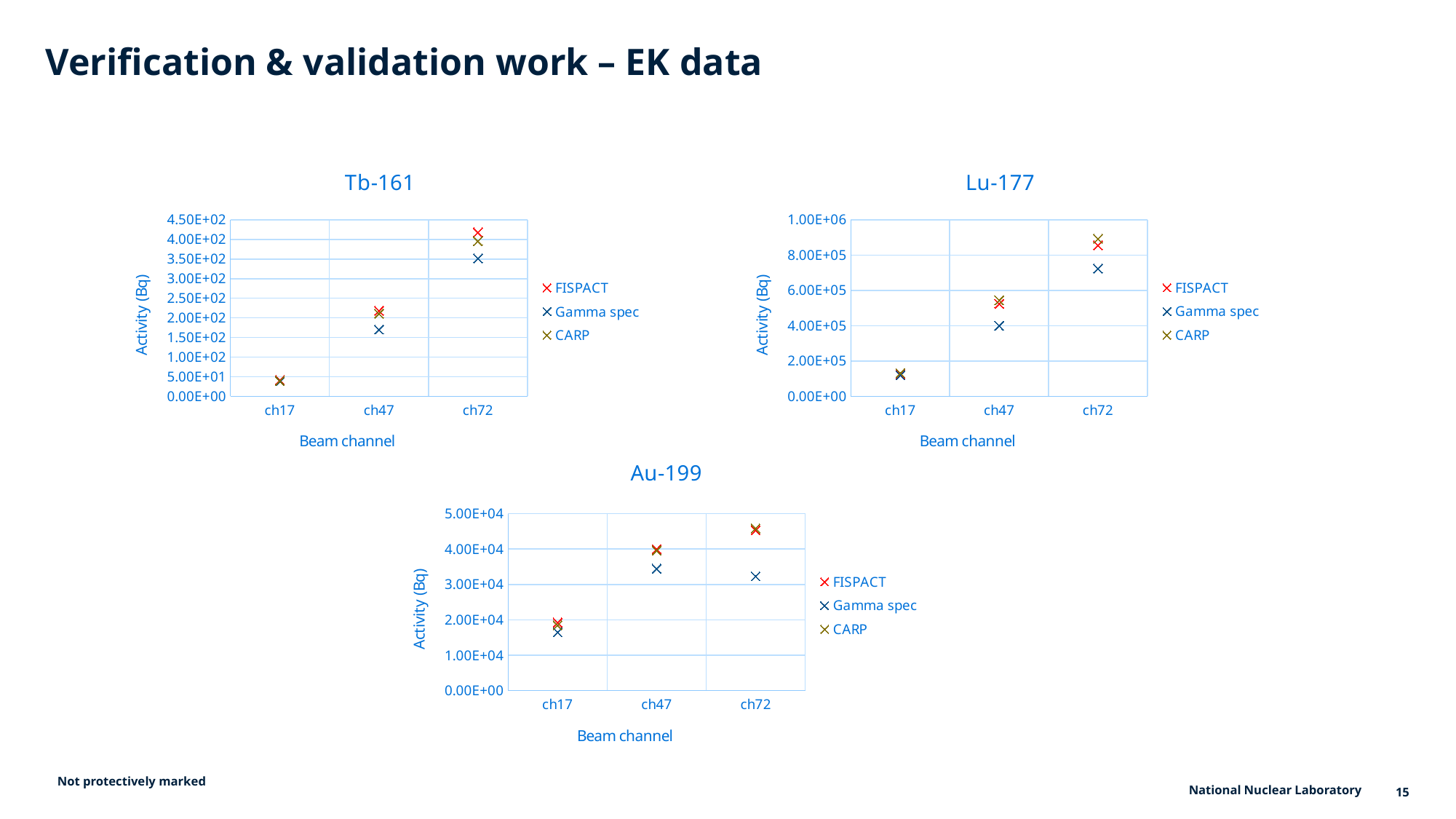
In the Au-199 chart, is the Gamma spec value for ch72 greater or less than 4.00E+04? less In the Tb-161 chart, is the FISPACT value for ch72 greater or less than 4.00E+02? greater In the Tb-161 chart, is the Gamma spec value for ch47 greater or less than 2.00E+02? less In the Au-199 chart, which beam channel has the highest FISPACT activity? ch72 How many series does the legend of the Lu-177 chart list? 3 How many beam channel categories are shown on the x axis of the Au-199 chart? 3 In the Lu-177 chart, which beam channel has the lowest Gamma spec activity? ch17 What type of chart is the Tb-161 chart? scatter chart In the Au-199 chart, at ch72, which is larger: the FISPACT value or the Gamma spec value? FISPACT In the Tb-161 chart, do the Gamma spec values rise or fall from ch17 to ch72? rise